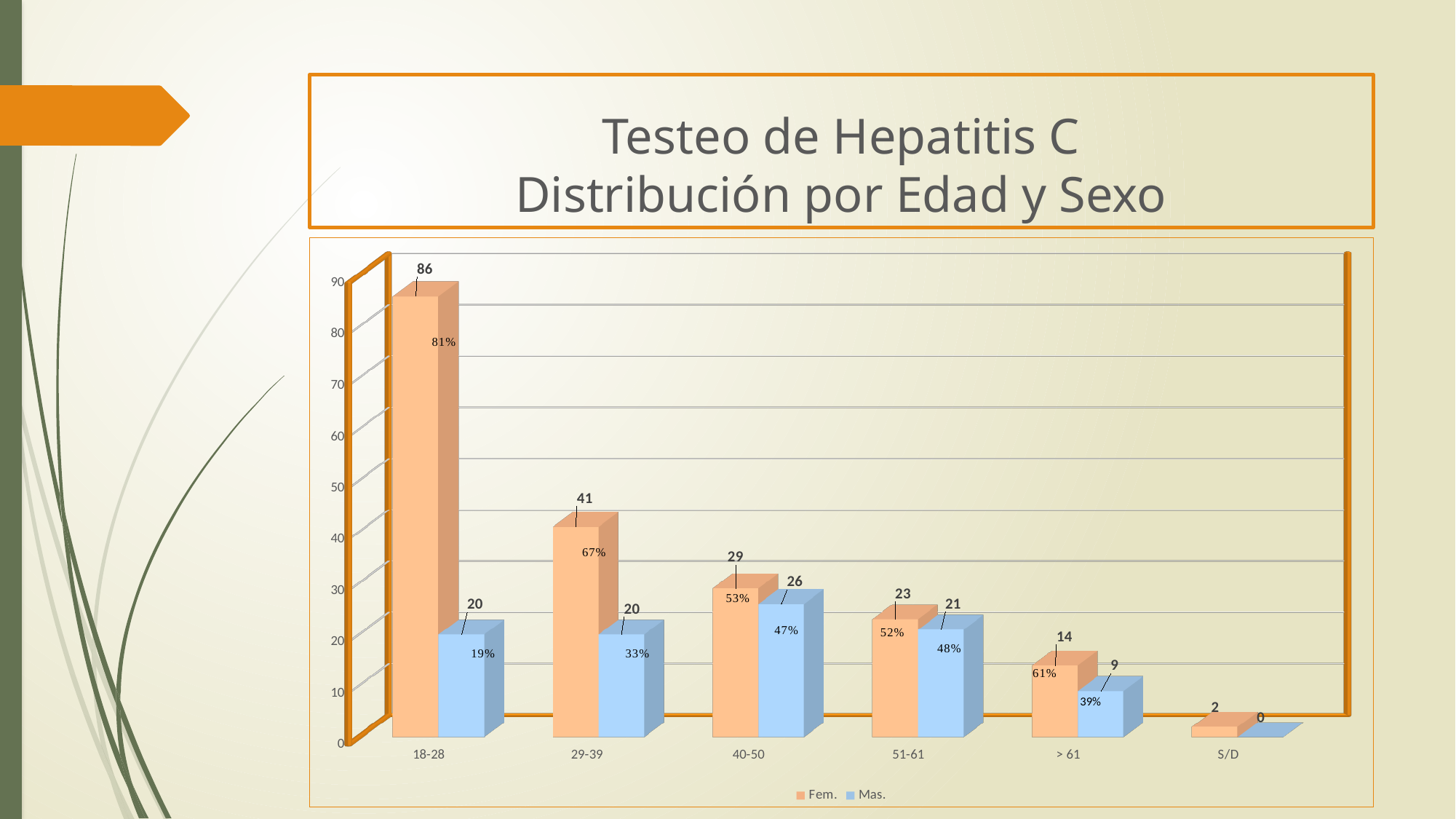
Which age group has the lowest Mas. value? S/D Which age group has the highest Fem. value? 18-28 How many age categories are shown on the x axis? 6 How many series does the legend list? 2 What is the Mas. value for the > 61 age group? 9 Which is larger for the 51-61 age group, the Fem. value or the Mas. value? Fem. Do the Fem. values rise or fall from 18-28 to S/D along the x axis? fall What is the title of the chart? Testeo de Hepatitis C Distribución por Edad y Sexo What is the Mas. value for the 40-50 age group? 26 What is the difference between the Fem. and Mas. values for the 29-39 age group? 21 What kind of chart is shown on the slide? bar chart What is the Fem. value for the 18-28 age group? 86